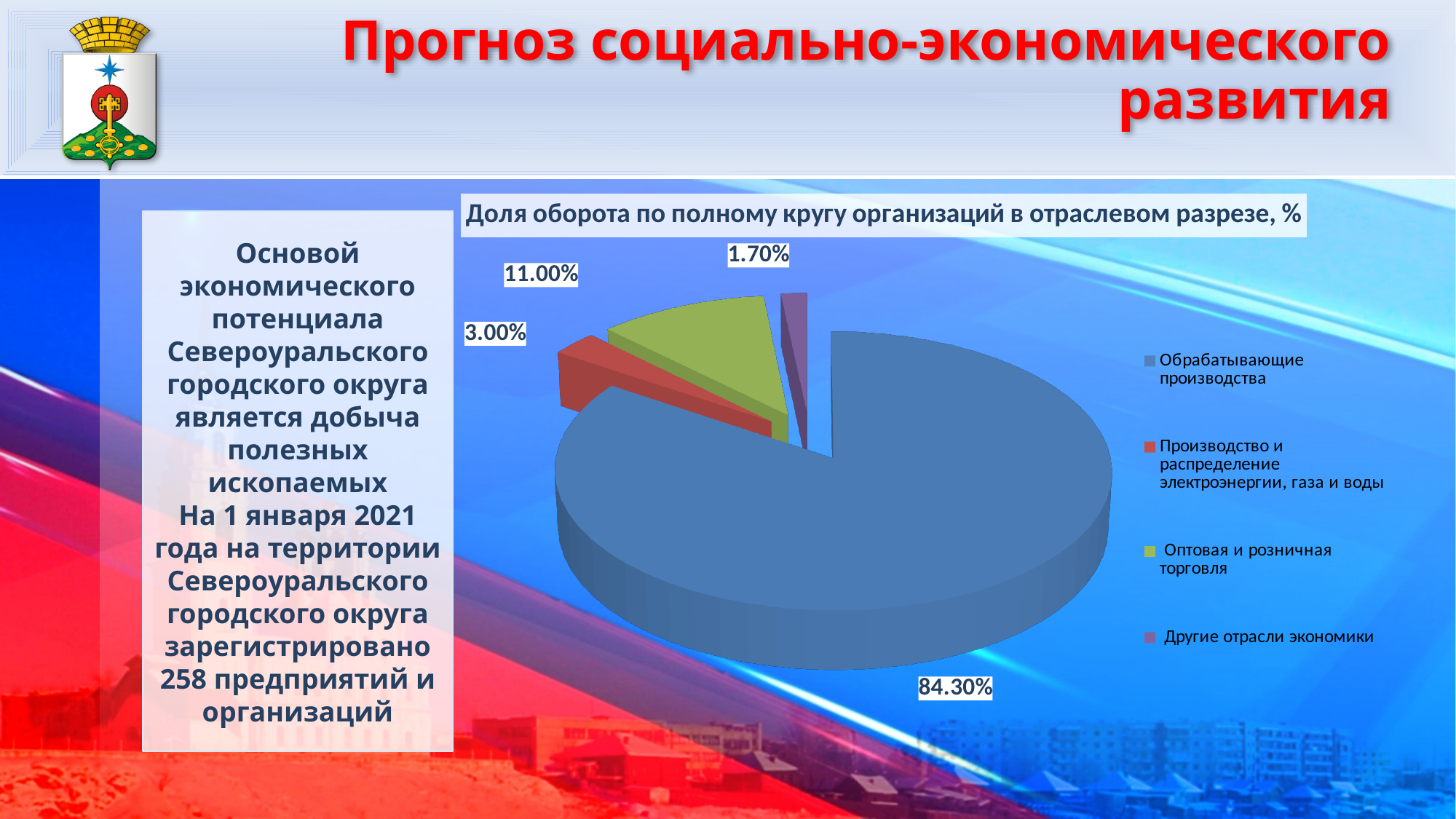
Which is larger: the share of Производство и распределение электроэнергии, газа и воды or the share of Другие отрасли экономики? Производство и распределение электроэнергии, газа и воды How many categories does the legend list? 4 What is the value for Производство и распределение электроэнергии, газа и воды? 3.00% What is the title of the chart? Доля оборота по полному кругу организаций в отраслевом разрезе, % What colour is the slice for Оптовая и розничная торговля? Green What is the value for Оптовая и розничная торговля? 11.00% What share of the pie does Обрабатывающие производства have? 84.30% Which category has the largest slice of the pie? Обрабатывающие производства What is the value for Другие отрасли экономики? 1.70% Which category has the smallest slice of the pie? Другие отрасли экономики What is the difference between the shares of Оптовая и розничная торговля and Производство и распределение электроэнергии, газа и воды? 8.00% What kind of chart is shown on the slide? Pie chart